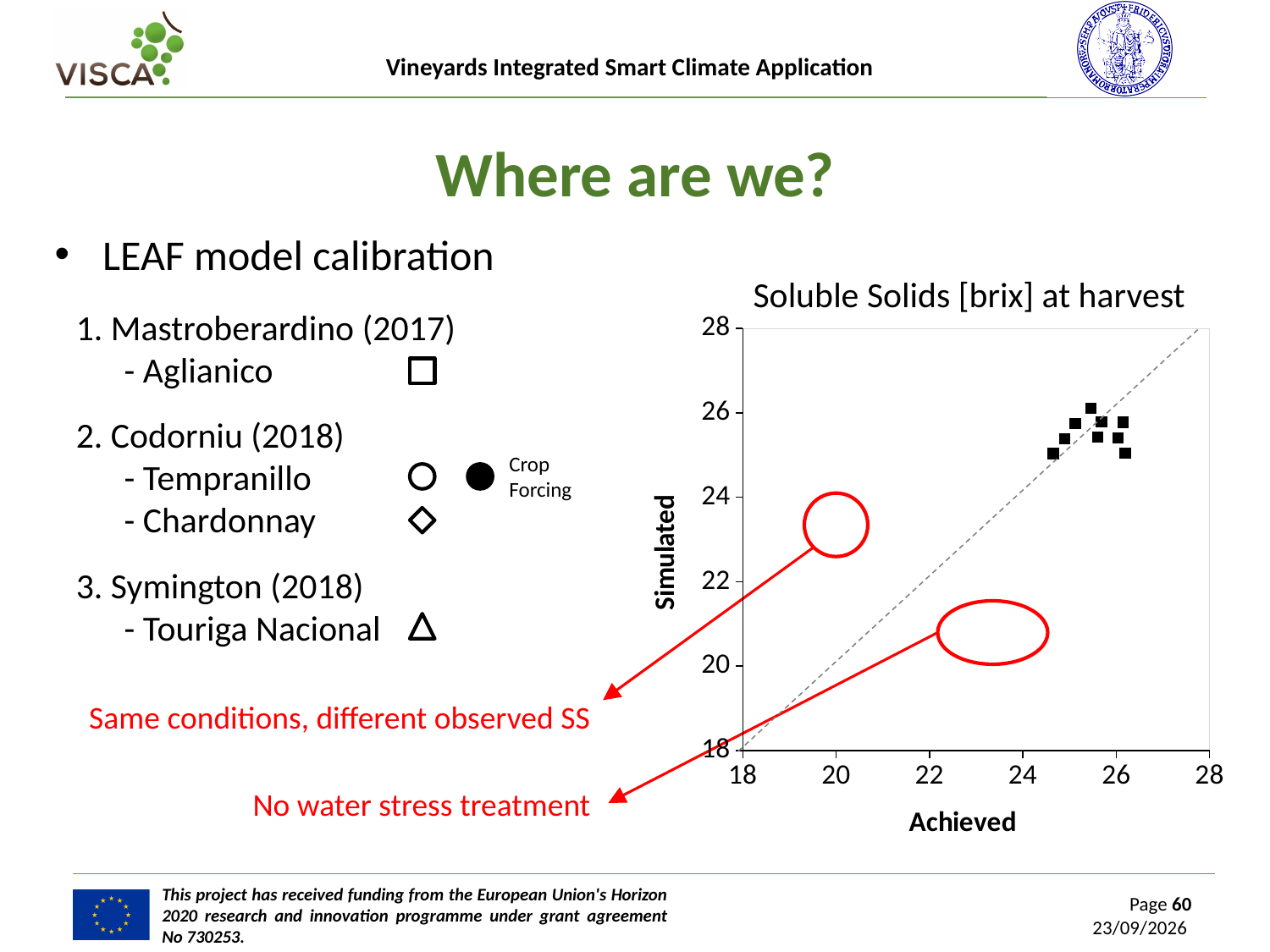
Are the plotted points on the chart greater or less than 24 on the Simulated axis? greater Is the lowest plotted point on the Simulated axis greater or less than 26? less What kind of chart is shown on the slide? Scatter chart What are the labels of the x axis and y axis of the chart? Achieved (x axis) and Simulated (y axis) Are the plotted points on the chart greater or less than 22 on the Achieved axis? greater What is the title of the chart on the slide? Soluble Solids [brix] at harvest